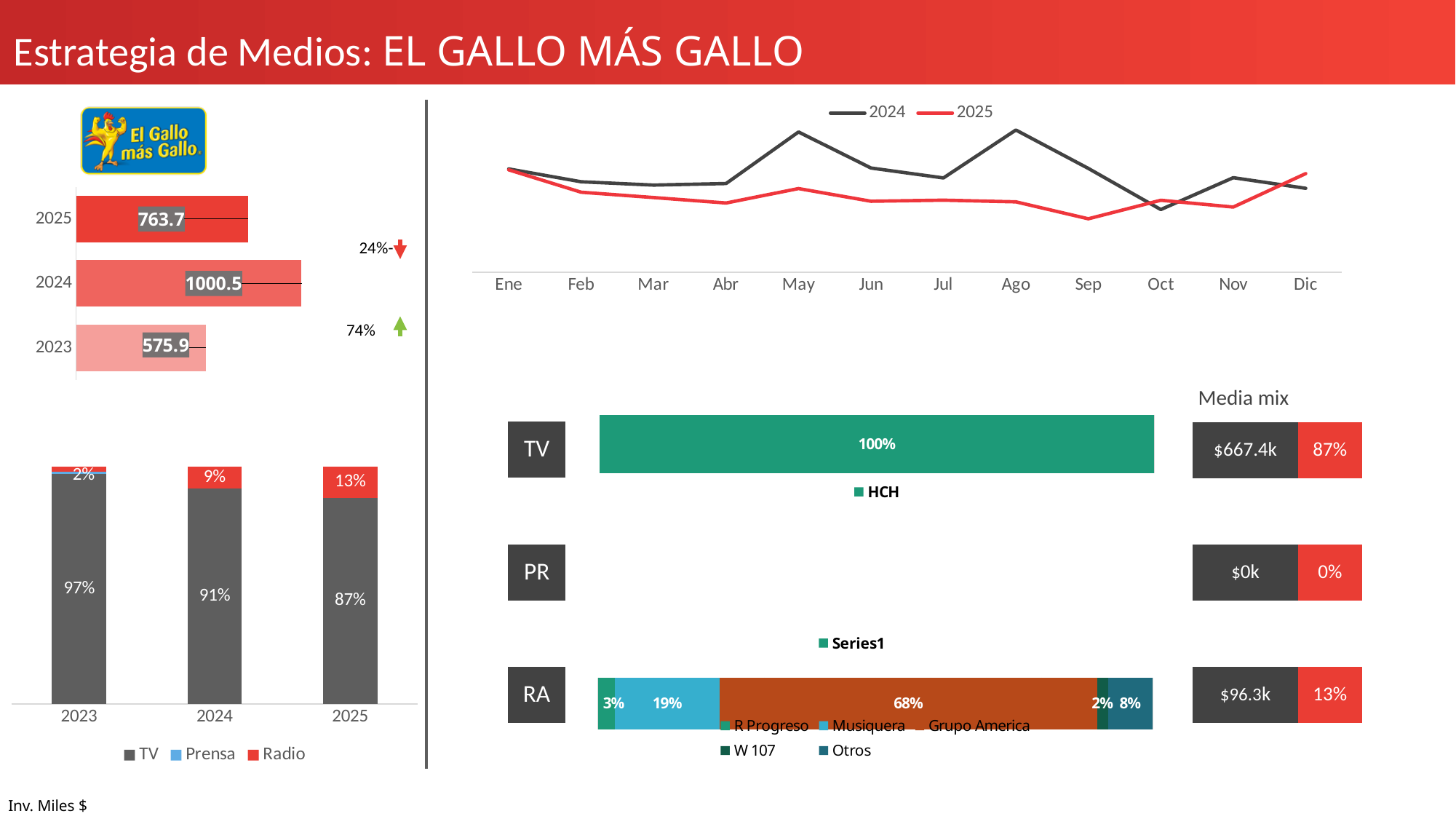
In the bottom-left stacked bar chart, how many series does the legend list? 3 In the top-left bar chart of yearly investment, what is the value for 2023? 575.9 In the bottom-left stacked bar chart, what share does TV have in 2025? 87% In the bottom-left stacked bar chart, what share does Radio have in 2024? 9% In the top-right line chart, which series is higher in May, 2024 or 2025? 2024 In the top-right line chart, how many months are shown on the x axis? 12 In the top-left bar chart of yearly investment, which year has the highest value? 2024 In the top-left bar chart of yearly investment, what is the difference between the 2024 and 2025 values? 236.8 In the Media mix table on the right, what is the amount for TV? $667.4k In the top-left bar chart of yearly investment, what is the value for 2024? 1000.5 In the RA bar on the right, what share does Grupo America have? 68% What kind of chart is the bottom-left chart showing TV, Prensa and Radio by year? Stacked bar chart